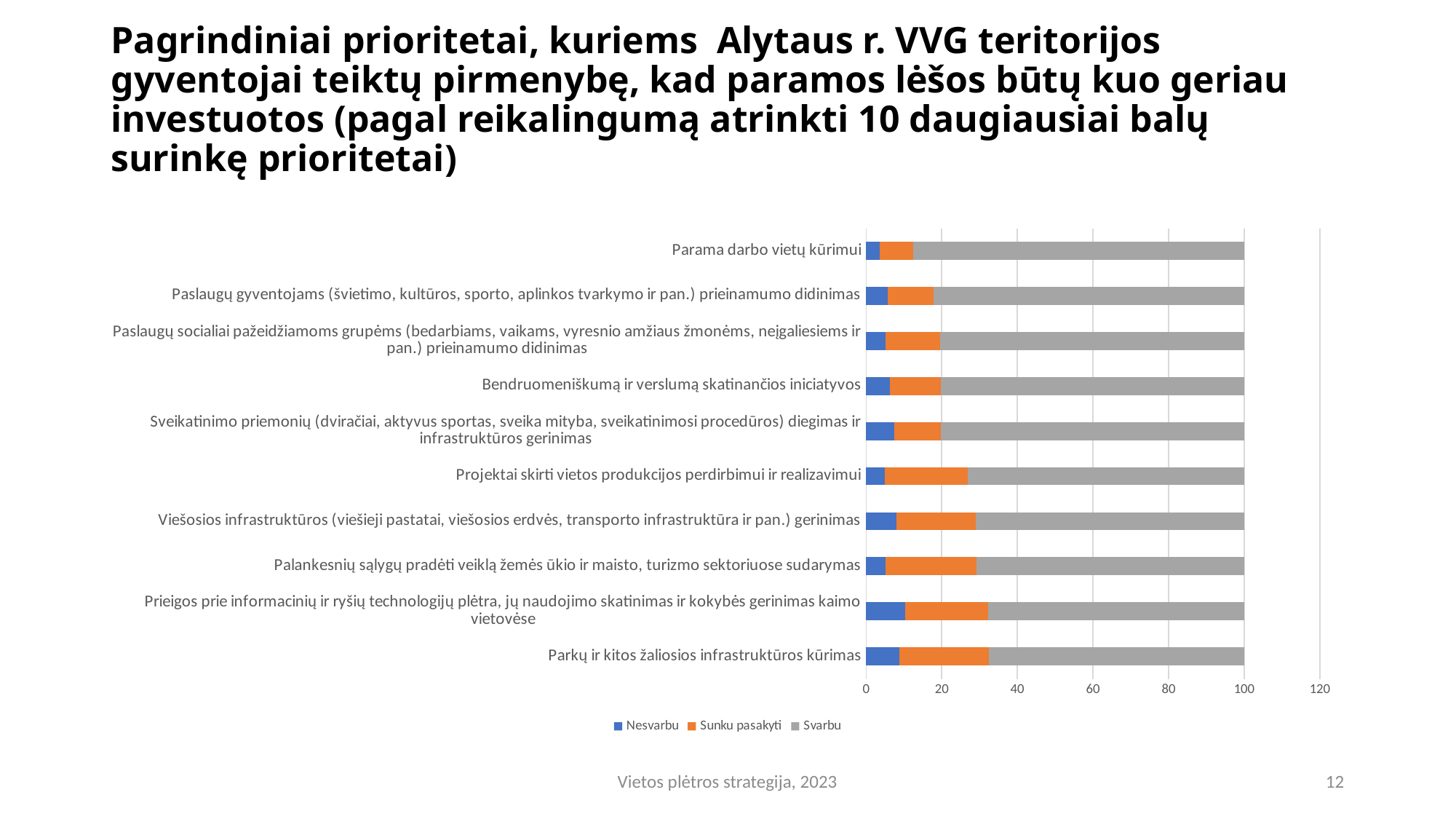
Which has the larger Nesvarbu value: Prieigos prie informacinių ir ryšių technologijų plėtra or Parama darbo vietų kūrimui? Prieigos prie informacinių ir ryšių technologijų plėtra How many series does the chart legend list? 3 What is the highest value shown on the horizontal axis? 120 Which category has the largest Svarbu segment? Parama darbo vietų kūrimui Is the Sunku pasakyti value for Parama darbo vietų kūrimui greater or less than 20? less Is the Nesvarbu value for Prieigos prie informacinių ir ryšių technologijų plėtra greater or less than 20? less How many priority categories are plotted on the chart? 10 What are the three series named in the legend? Nesvarbu, Sunku pasakyti, Svarbu What is the total of the stacked bar for Parama darbo vietų kūrimui? 100 Is the Svarbu value for Parkų ir kitos žaliosios infrastruktūros kūrimas greater or less than 80? less What kind of chart is shown on the slide? Stacked bar chart